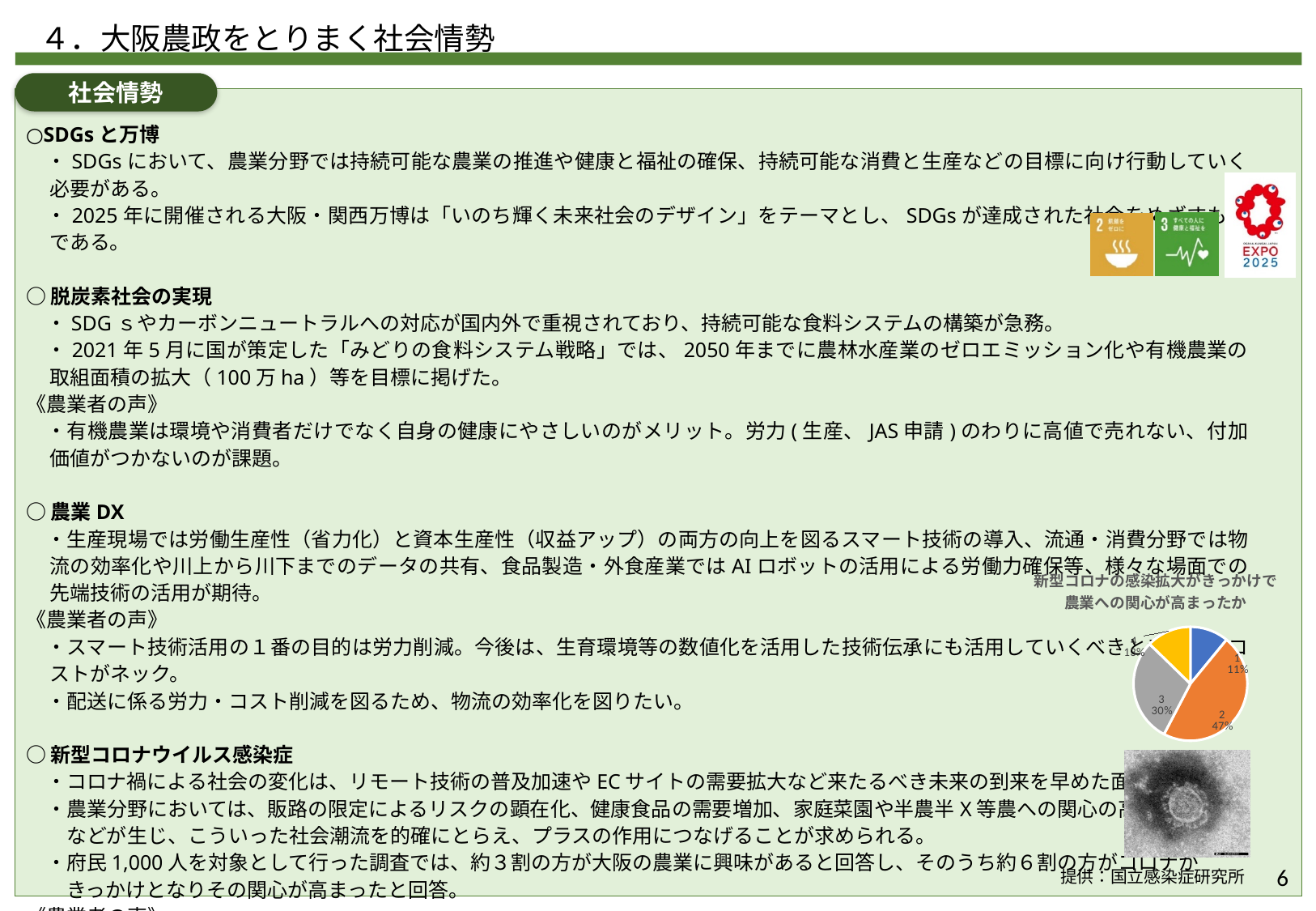
In the pie chart, what is the difference in percentage points between category 2 and category 1? 36 Which category has the largest slice in the pie chart? 2 In the pie chart, what share does category 2 have? 47% What is the title of the pie chart on the slide? 新型コロナの感染拡大がきっかけで農業への関心が高まったか What kind of chart is shown on the slide? pie chart How many slices does the pie chart have? 4 What colour is the largest slice of the pie chart? orange In the pie chart, what is the difference in percentage points between category 2 and category 3? 17 In the pie chart, what share does category 1 have? 11% In the pie chart, what share does category 3 have? 30% In the pie chart, which is larger: the share of category 2 or category 3? 2